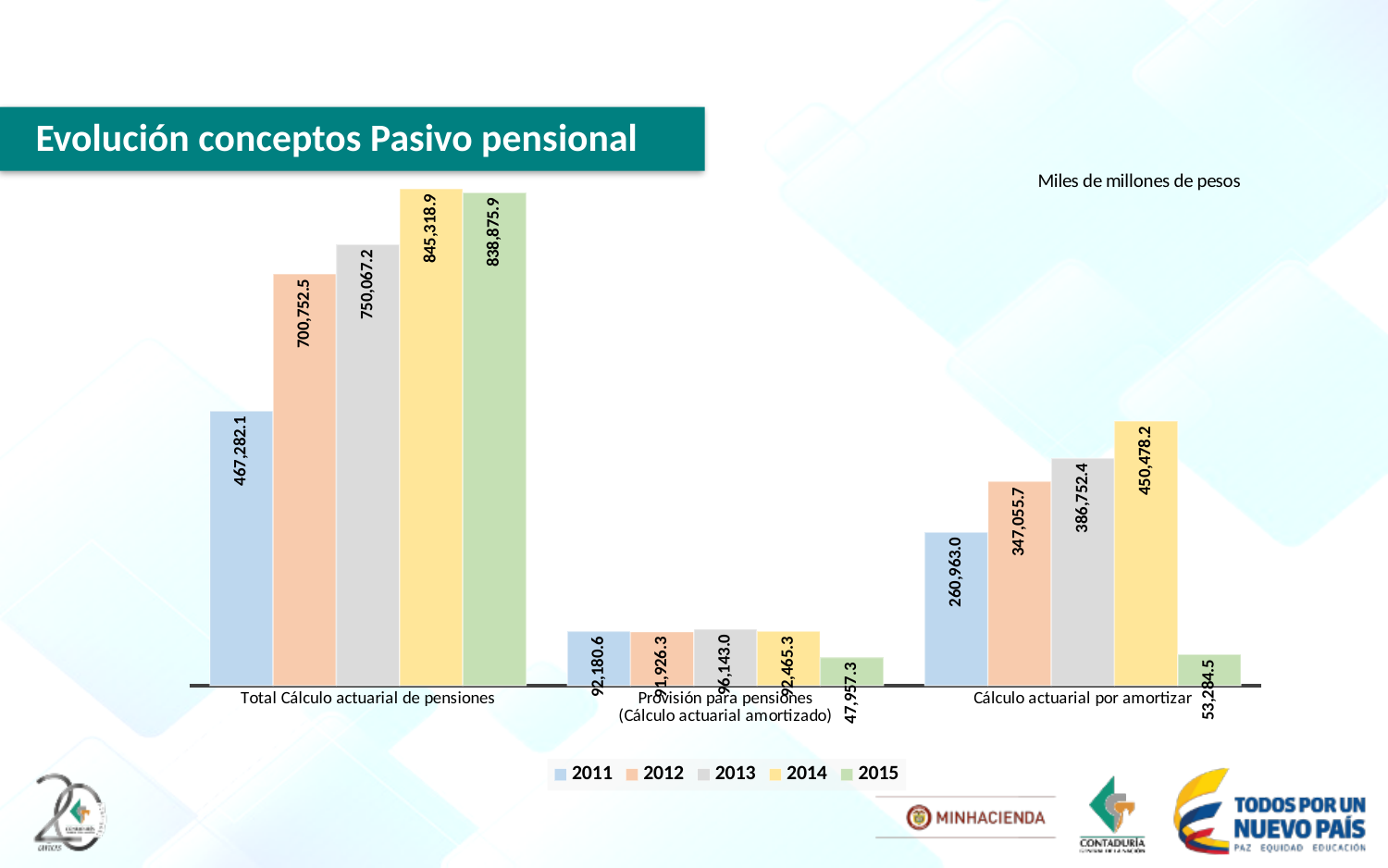
How many series does the legend list? 5 What is the value for 2014 in the category Total Cálculo actuarial de pensiones? 845,318.9 What is the value for 2011 in the category Cálculo actuarial por amortizar? 260,963.0 What unit is stated for the values in the chart? Miles de millones de pesos What is the value for 2015 in the category Provisión para pensiones (Cálculo actuarial amortizado)? 47,957.3 What type of chart is shown on the slide? bar chart Which year has the highest value in the category Total Cálculo actuarial de pensiones? 2014 In the category Total Cálculo actuarial de pensiones, which is larger: the value for 2012 or the value for 2013? 2013 How many categories are shown on the x axis? 3 What is the title of the chart? Evolución conceptos Pasivo pensional Which year has the lowest value in the category Cálculo actuarial por amortizar? 2015 What is the difference between the 2014 and 2011 values in the category Cálculo actuarial por amortizar? 189,515.2